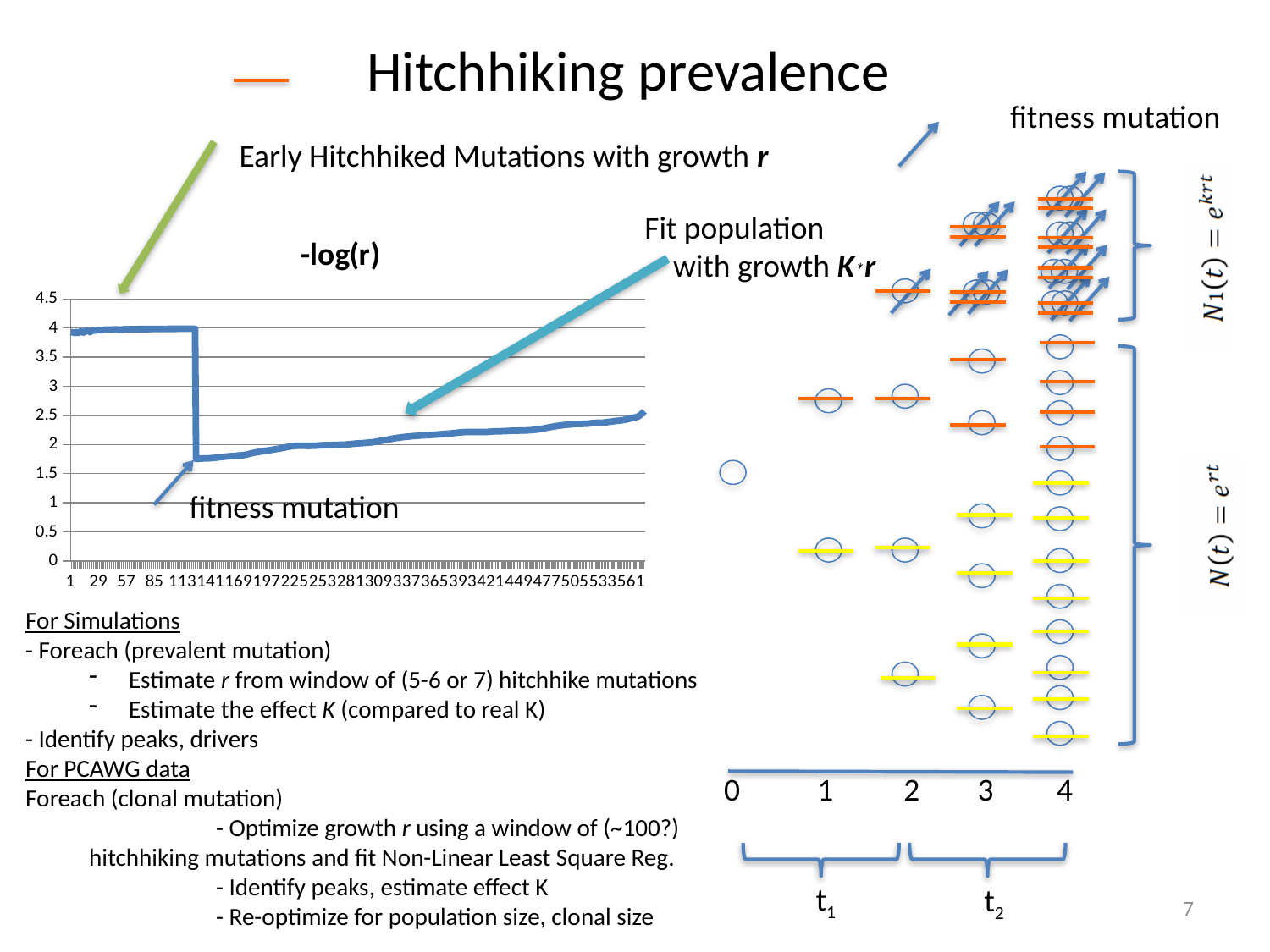
Comparing the start of the line to its end, does the value rise or fall overall? fall What is the title of the chart? -log(r) What is the highest tick value shown on the y axis? 4.5 After the sharp drop, does the line rise or fall as x increases toward 561? rise How many lines are plotted on the chart? 1 Which is larger, the value of the line at x = 1 or at x = 561? x = 1 Is the value of the line at x = 281 greater or less than 2.5? less Is the value of the line at x = 561 greater or less than 3? less Is the value of the line at x = 1 greater or less than 3? greater What kind of chart is shown on the slide? line chart